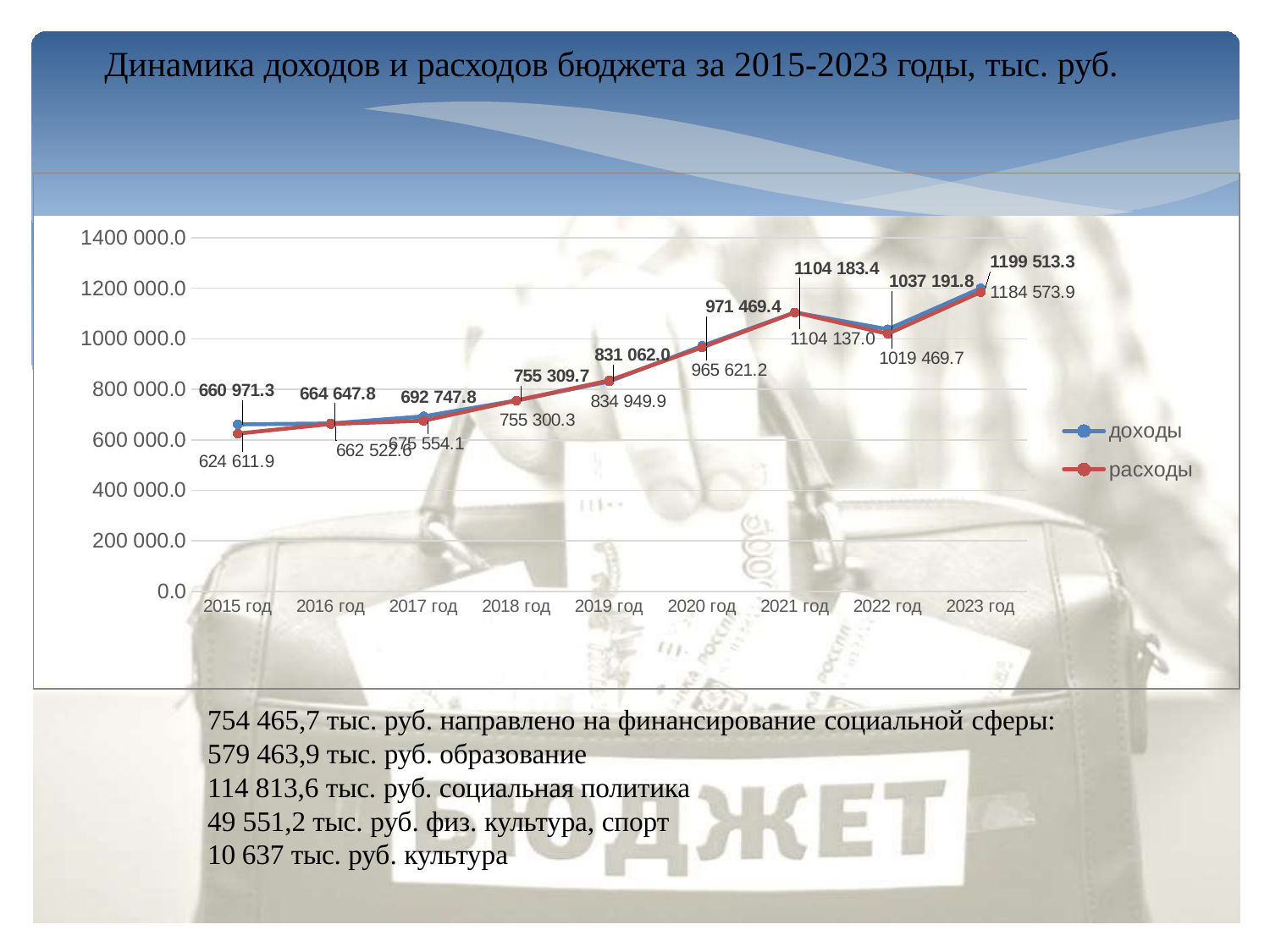
Is the value of доходы for 2020 год greater or less than 800 000.0? greater What is the value of доходы for 2019 год? 831 062.0 Do the values of доходы rise or fall from 2015 год to 2021 год? rise In which year is расходы lowest? 2015 год What is the value of расходы for 2022 год? 1019 469.7 How many series does the legend list? 2 What is the difference between доходы and расходы in 2015 год? 36 359.4 How many years are shown on the x axis? 9 Which is larger in 2022 год, доходы or расходы? доходы What is the value of доходы for 2015 год? 660 971.3 What kind of chart is shown on the slide? line chart In which year is доходы highest? 2023 год